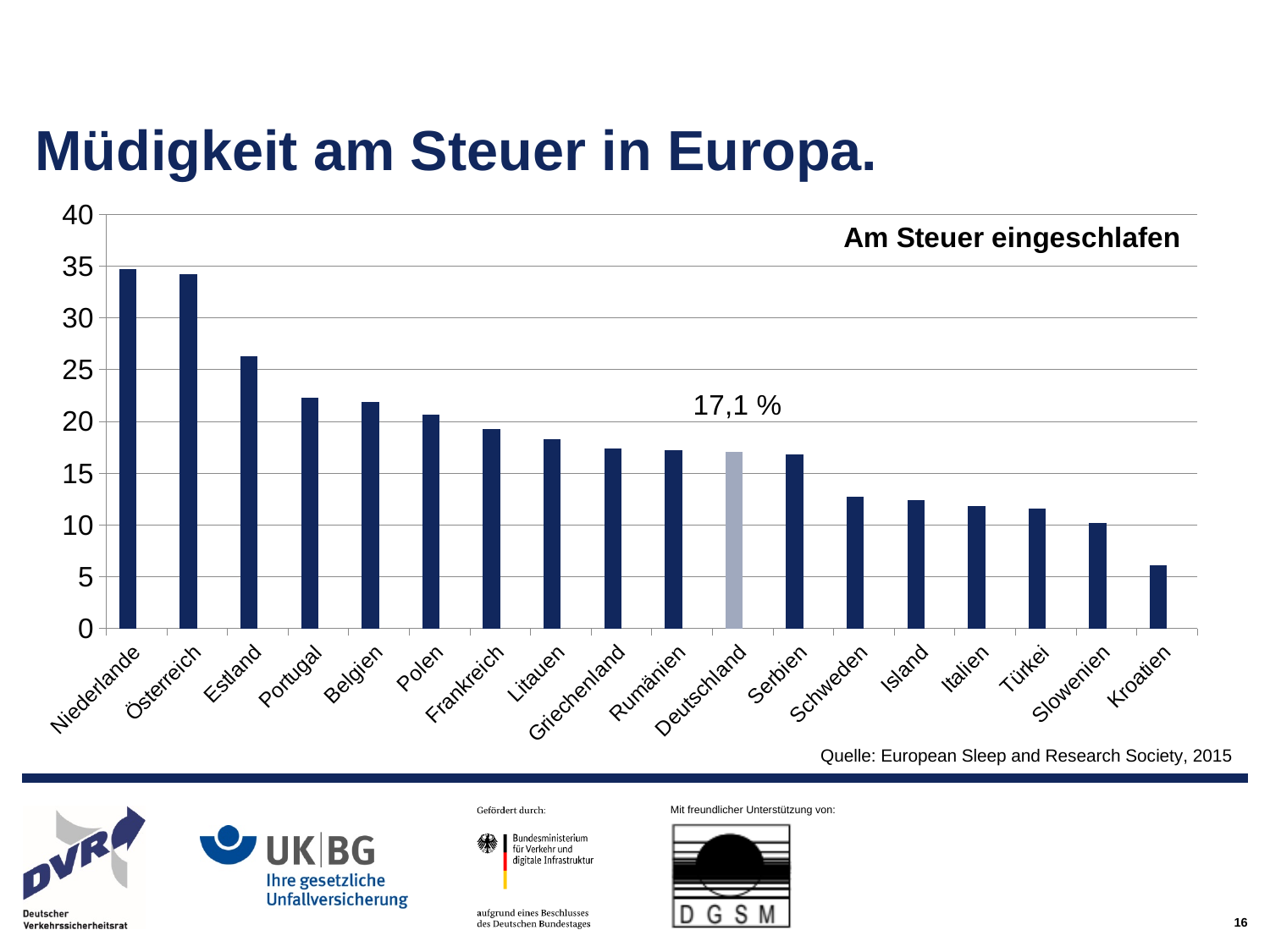
Which country has the lowest bar in the chart? Kroatien Is the value for Schweden greater or less than 15? less What value is labelled on the bar for Deutschland? 17,1 % Is the value for Estland greater or less than 25? greater Is the value for Niederlande greater or less than 30? greater Which country's bar is drawn in a different (lighter) colour from the others? Deutschland Which has the larger value, Estland or Portugal? Estland What kind of chart is shown on the slide? bar chart Which has the larger value, Slowenien or Kroatien? Slowenien How many countries are shown on the x axis? 18 Do the values rise or fall from left to right along the x axis? fall